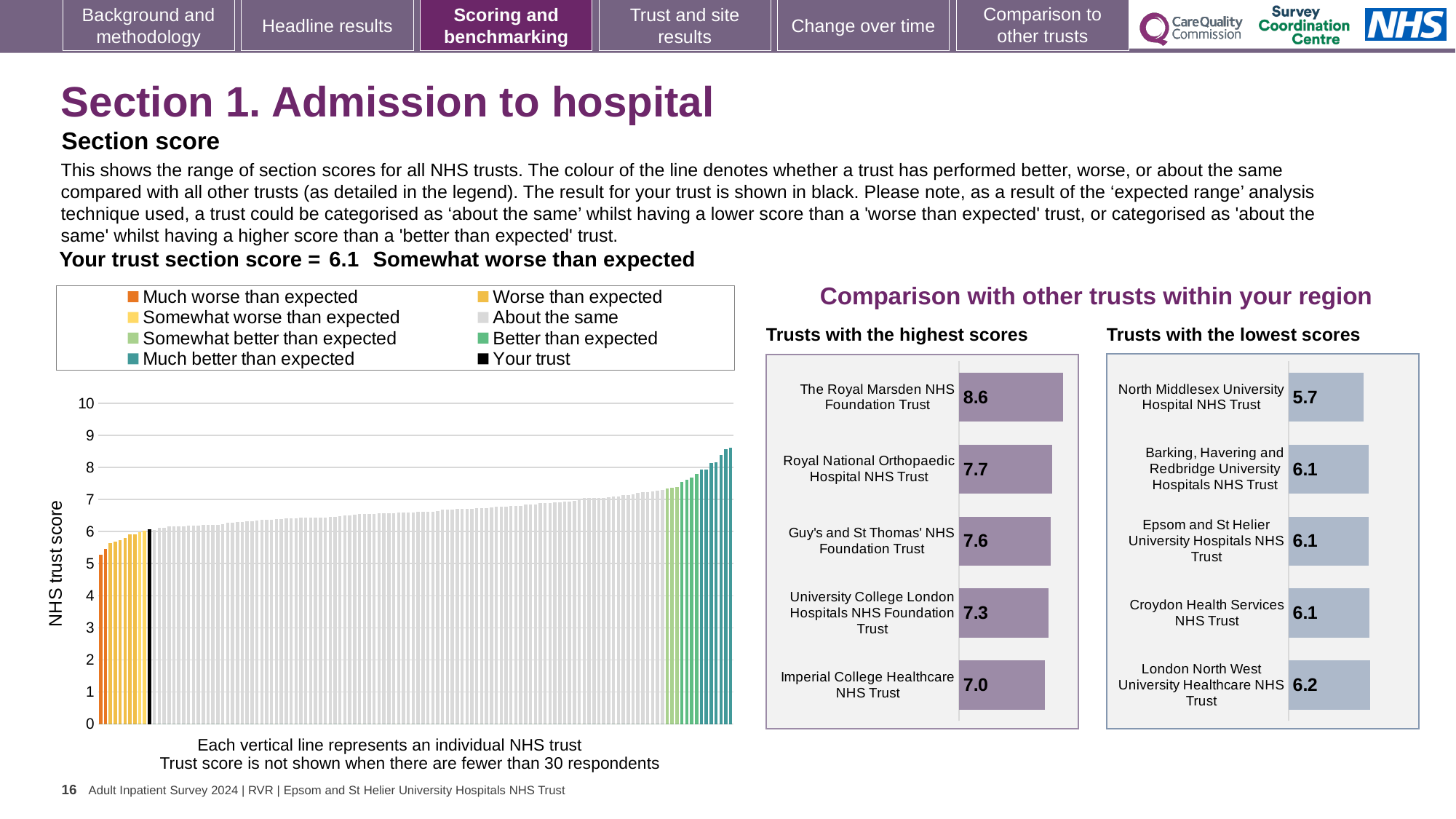
In the main NHS trust score chart on the left, do the bar values rise or fall from left to right? rise In the 'Trusts with the highest scores' chart, which has the higher score: Guy's and St Thomas' NHS Foundation Trust or University College London Hospitals NHS Foundation Trust? Guy's and St Thomas' NHS Foundation Trust In the 'Trusts with the highest scores' chart, what is the score for Imperial College Healthcare NHS Trust? 7.0 In the 'Trusts with the lowest scores' chart, which trust has the highest score shown? London North West University Healthcare NHS Trust In the 'Trusts with the highest scores' chart, what is the score for The Royal Marsden NHS Foundation Trust? 8.6 How many trusts are shown in the 'Trusts with the lowest scores' chart? 5 In the 'Trusts with the highest scores' chart, what is the difference between the scores of The Royal Marsden NHS Foundation Trust and Royal National Orthopaedic Hospital NHS Trust? 0.9 In the 'Trusts with the highest scores' chart, which trust has the lowest score shown? Imperial College Healthcare NHS Trust How many entries does the legend of the main NHS trust score chart on the left list? 8 In the 'Trusts with the lowest scores' chart, what is the score for North Middlesex University Hospital NHS Trust? 5.7 In the 'Trusts with the lowest scores' chart, what is the difference between the scores of London North West University Healthcare NHS Trust and North Middlesex University Hospital NHS Trust? 0.5 In the main NHS trust score chart on the left, is the value of the tallest bar greater or less than 8? greater